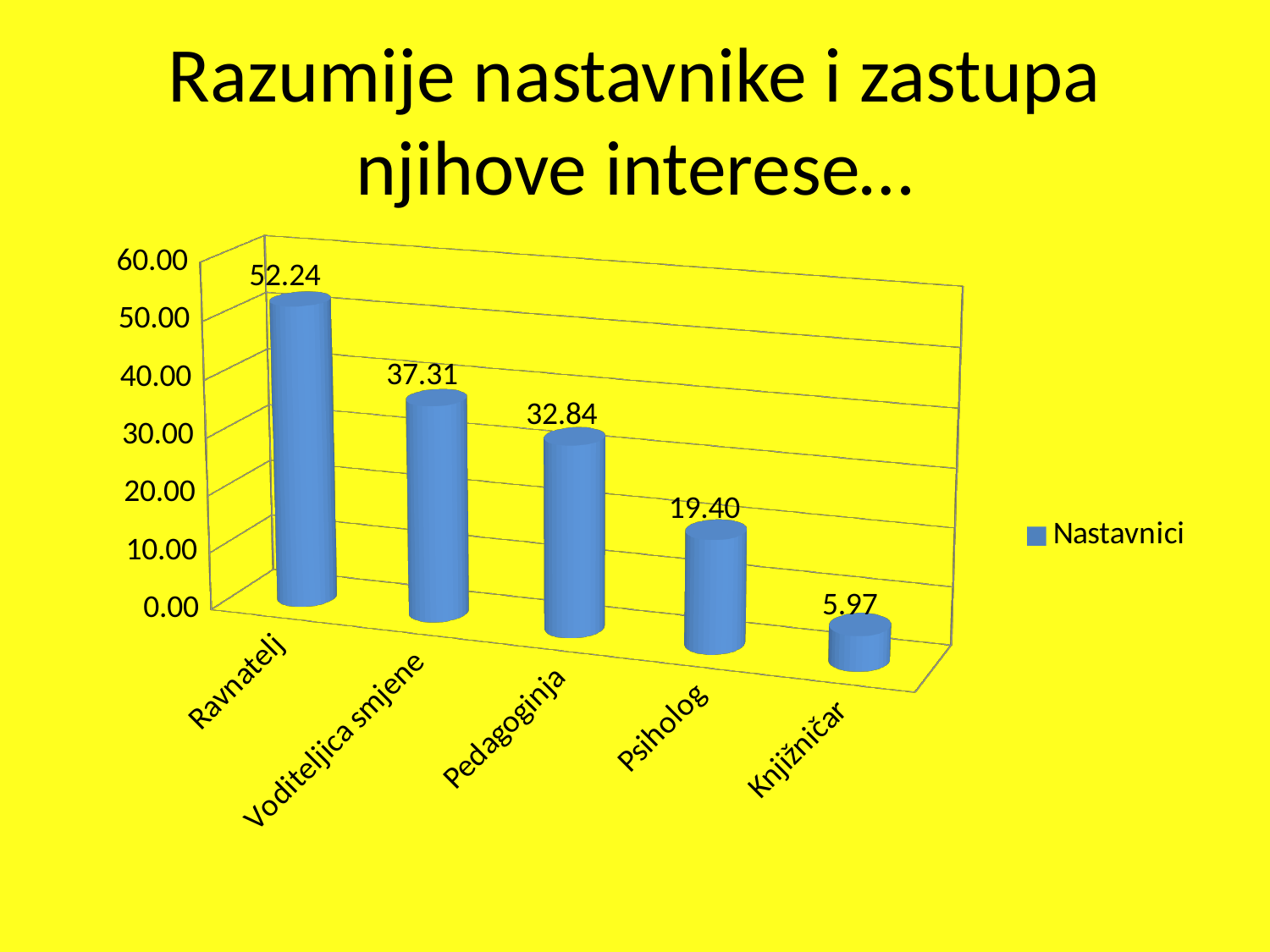
How many categories are shown on the x axis? 5 What series name does the legend list? Nastavnici Which category has the lowest value? Knjižničar What is the value for Pedagoginja? 32.84 What is the value for Voditeljica smjene? 37.31 What is the difference between the values for Ravnatelj and Voditeljica smjene? 14.93 What kind of chart is shown on the slide? Bar chart Which category has the highest value? Ravnatelj Which is larger, the value for Pedagoginja or the value for Psiholog? Pedagoginja What is the value for Ravnatelj? 52.24 What is the value for Knjižničar? 5.97 What is the value for Psiholog? 19.40